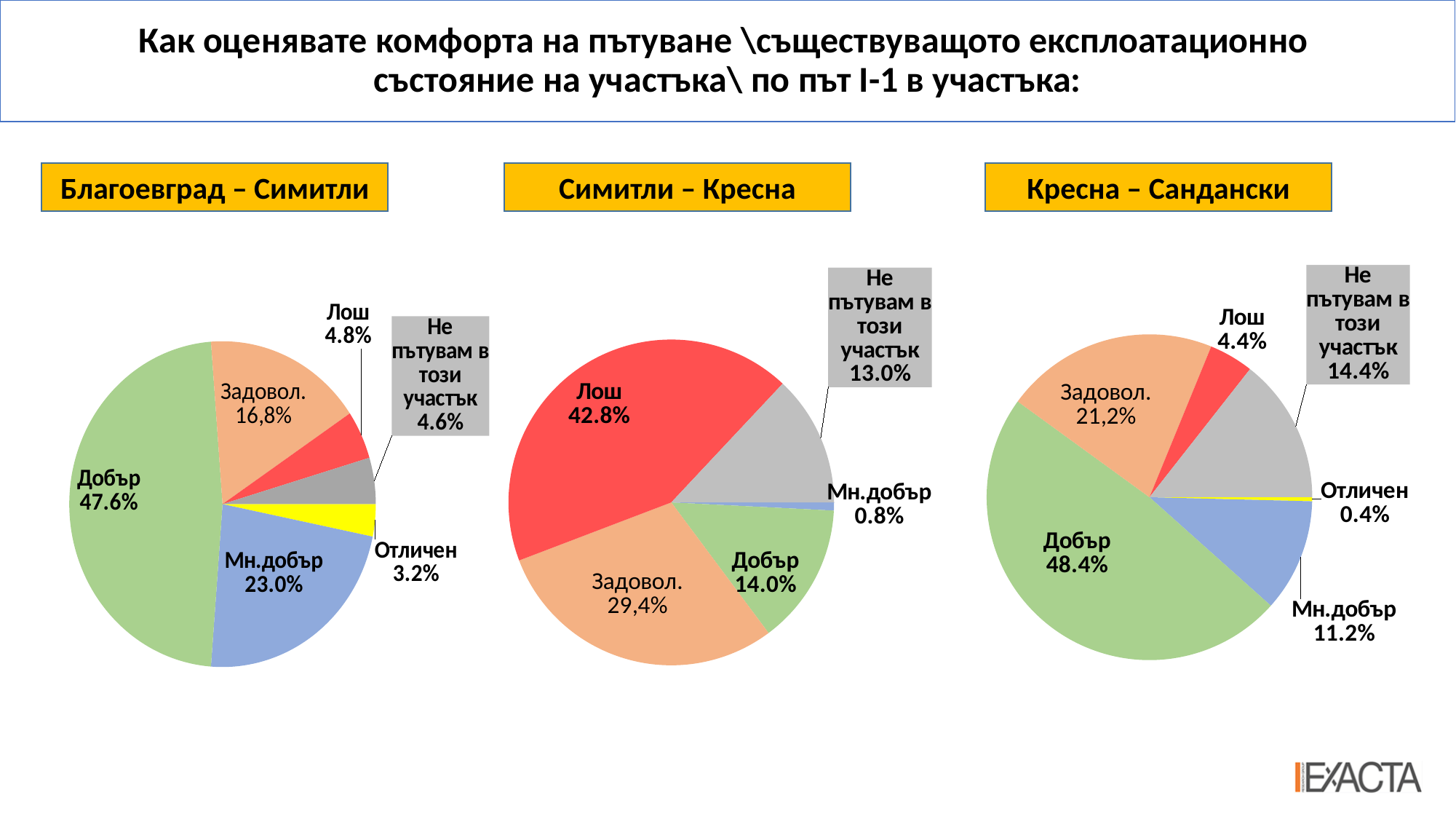
In the Симитли – Кресна chart, which is larger, the Добър slice or the Не пътувам в този участък slice? Добър In the Благоевград – Симитли chart, what share is labelled for Мн.добър? 23.0% In the Симитли – Кресна chart, what share is labelled for Задовол.? 29,4% In the Симитли – Кресна chart, which category has the smallest slice? Мн.добър What type of chart is used for the Благоевград – Симитли section? Pie chart In the Кресна – Сандански chart, what is the difference between the Добър and Мн.добър shares? 37.2% How many slices does the Симитли – Кресна pie chart have? 5 In the Симитли – Кресна chart, what share is labelled for Лош? 42.8% In the Кресна – Сандански chart, which category has the largest slice? Добър In the Благоевград – Симитли chart, which category has the smallest slice? Отличен In the Благоевград – Симитли chart, what share is labelled for Добър? 47.6% In the Кресна – Сандански chart, what share is labelled for Не пътувам в този участък? 14.4%